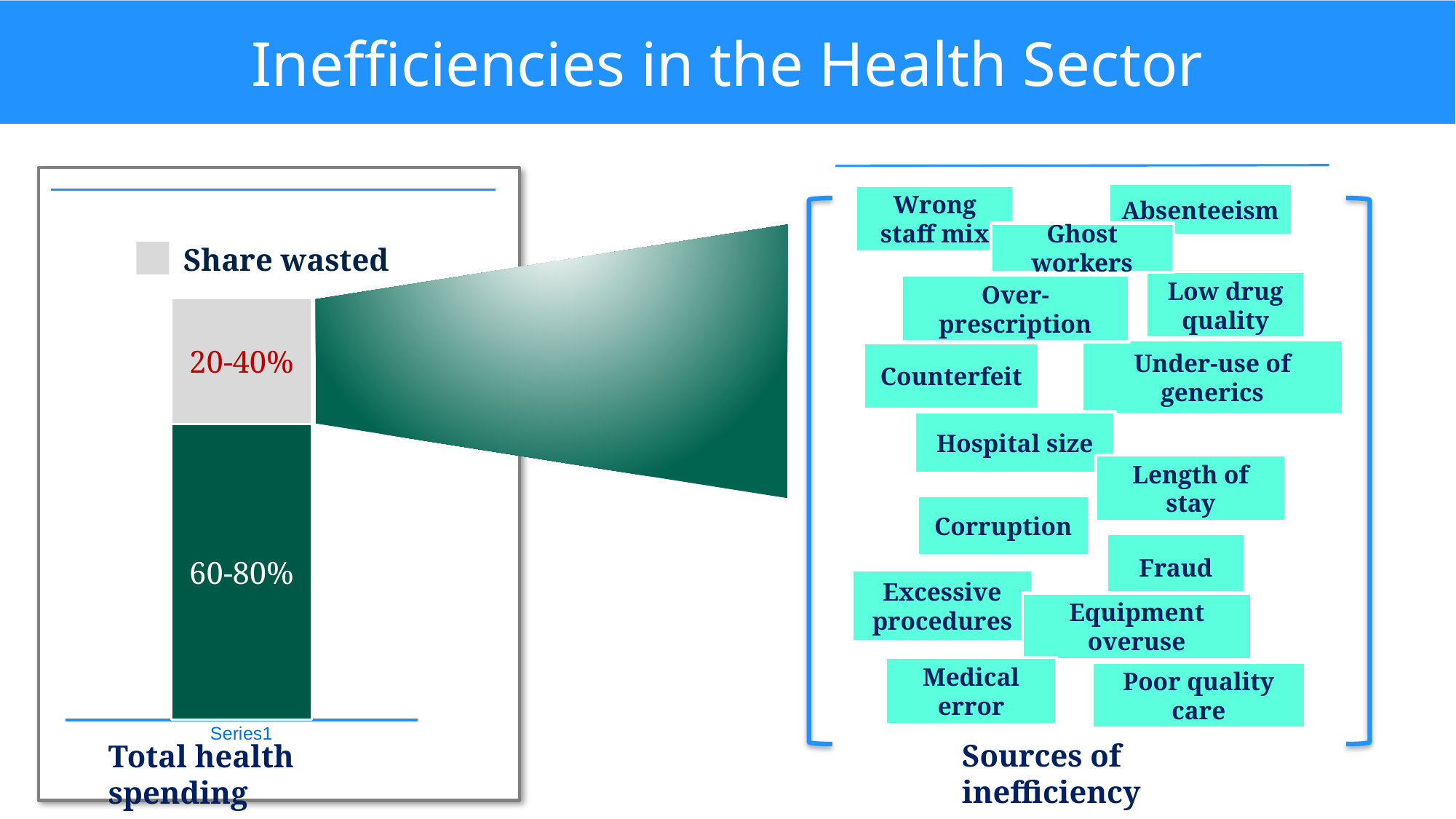
Which segment of the bar is at the top, the 20-40% segment or the 60-80% segment? the 20-40% segment Which segment of the bar is larger, the grey 'Share wasted' segment or the dark green segment? the dark green segment What is the category label shown under the bar on the x axis? Series1 What kind of chart is shown on the left of the slide? stacked bar chart What value is printed on the dark green segment of the bar? 60-80% What value is printed on the grey 'Share wasted' segment of the bar? 20-40% What colour is the 'Share wasted' segment of the bar? grey What is the only entry shown in the chart's legend? Share wasted How many bars are plotted in the chart? 1